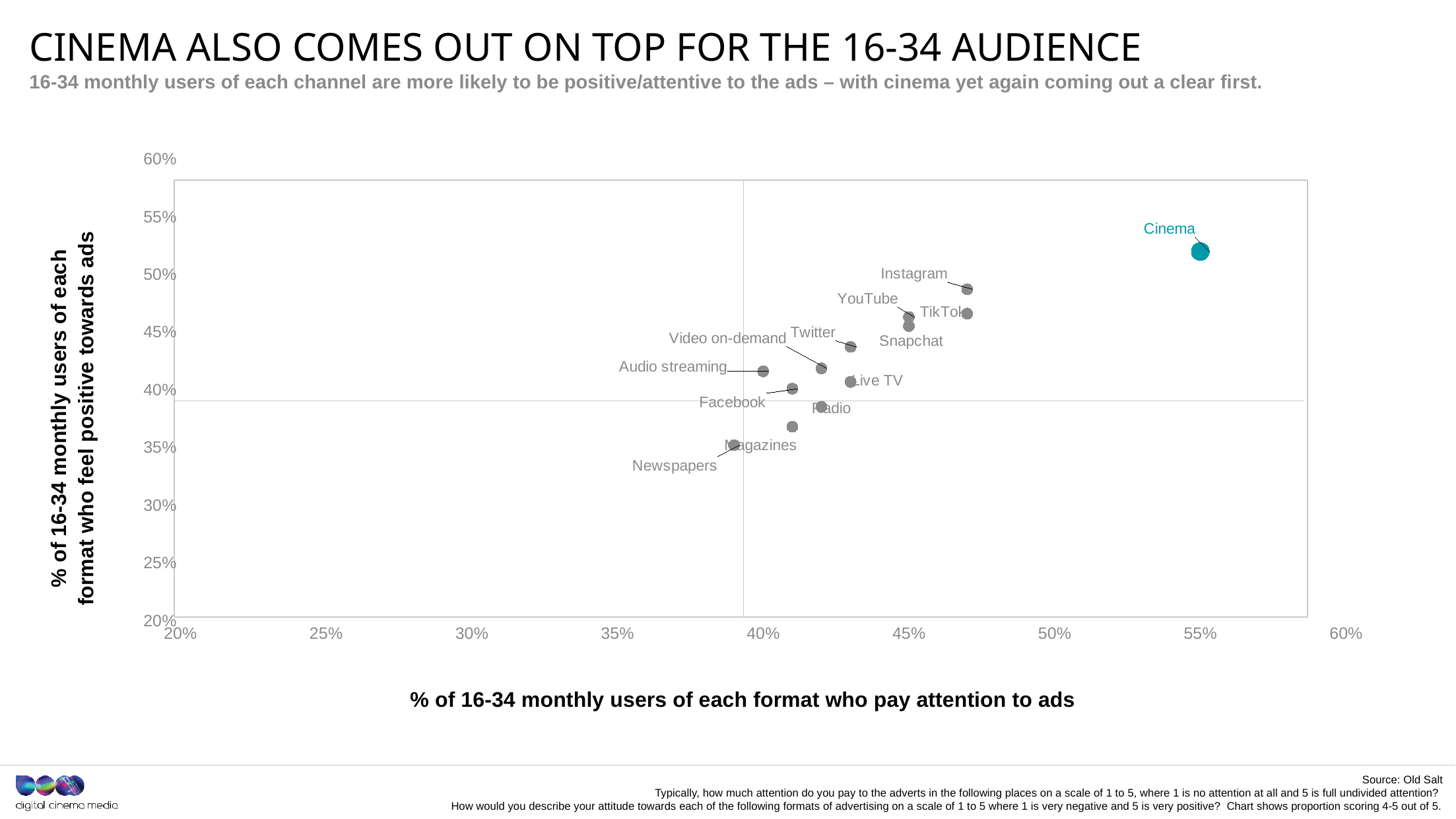
How many formats are plotted as points on the chart? 13 What kind of chart is shown on the slide? Scatter chart Is the percentage of 16-34 monthly users who feel positive towards ads for Newspapers greater or less than 40%? less Which has a higher percentage of 16-34 monthly users who feel positive towards ads, Instagram or TikTok? Instagram Which format has the lowest percentage of 16-34 monthly users who feel positive towards ads? Newspapers Is the percentage of 16-34 monthly users who feel positive towards ads for Twitter greater or less than 40%? greater Is the percentage of 16-34 monthly users who pay attention to ads for Cinema greater or less than 50%? greater Which point on the chart is highlighted in a different colour from the others? Cinema Which has a higher percentage of 16-34 monthly users who feel positive towards ads, Magazines or Newspapers? Magazines Which format has the highest percentage of 16-34 monthly users who feel positive towards ads? Cinema Which format has the highest percentage of 16-34 monthly users who pay attention to ads? Cinema